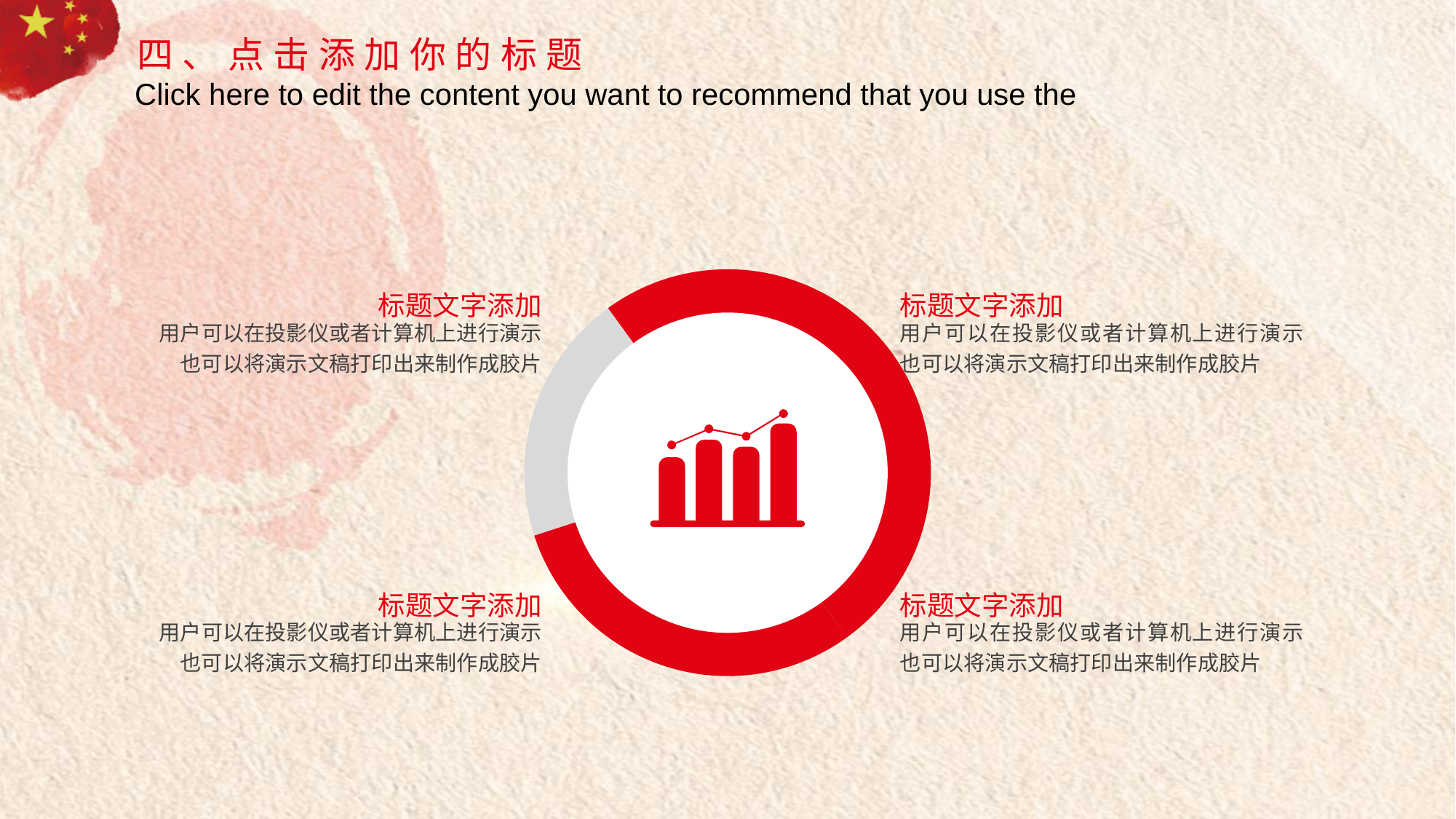
Which colour segment takes up the smallest share of the donut chart? Grey Does the donut chart display any data labels or a legend? No What two colours are used for the segments of the donut chart? Red and grey Which segment of the donut chart is larger, the red one or the grey one? The red one What kind of chart is shown in the centre of the slide? Donut chart